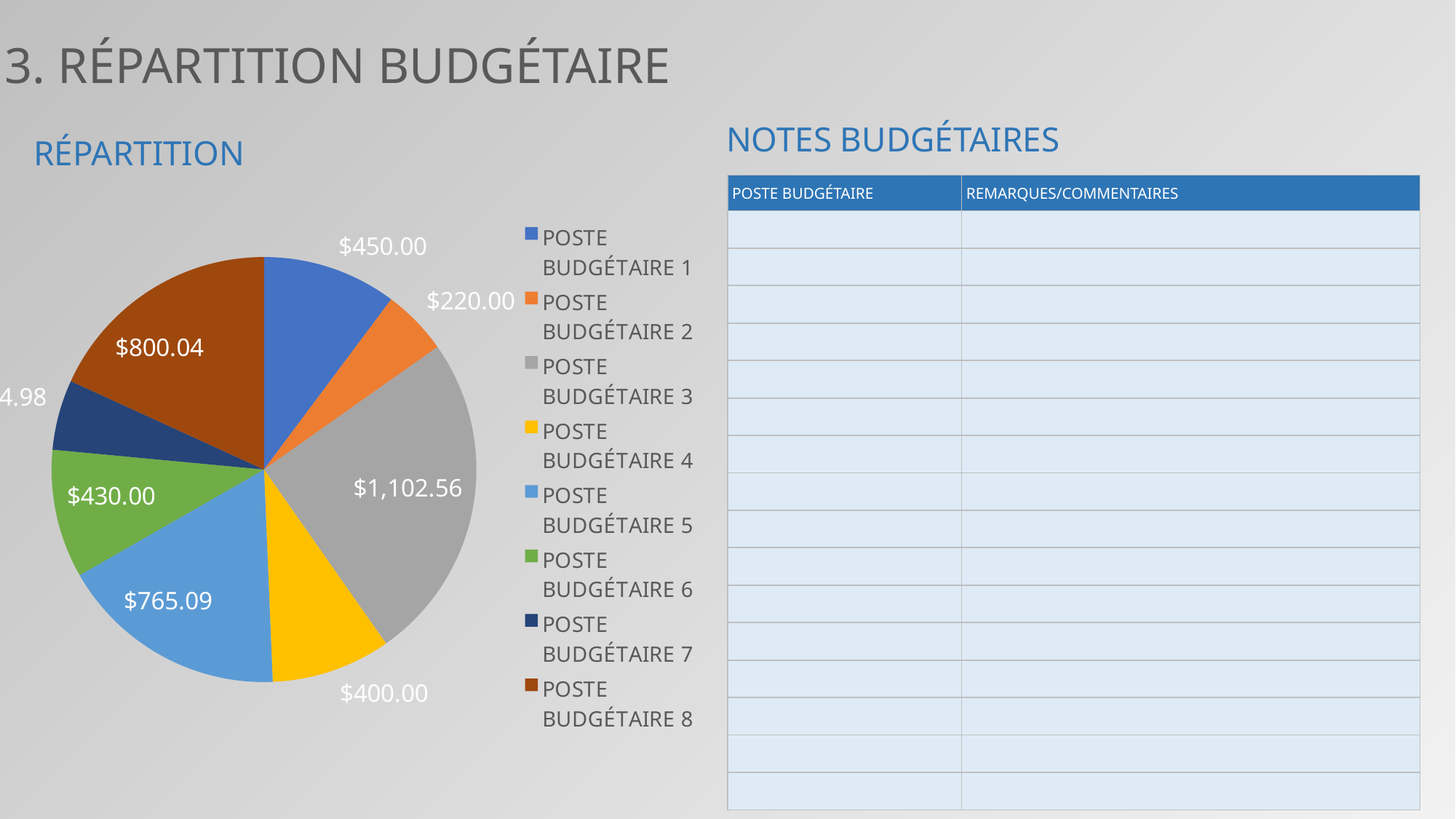
In the RÉPARTITION pie chart, which is larger: POSTE BUDGÉTAIRE 6 or POSTE BUDGÉTAIRE 4? POSTE BUDGÉTAIRE 6 In the RÉPARTITION pie chart, what is the value for POSTE BUDGÉTAIRE 8? $800.04 In the RÉPARTITION pie chart, what is the value for POSTE BUDGÉTAIRE 1? $450.00 How many slices does the RÉPARTITION pie chart have? 8 What kind of chart is shown under the heading RÉPARTITION? Pie chart How many entries does the legend of the RÉPARTITION pie chart list? 8 In the RÉPARTITION pie chart, what is the value for POSTE BUDGÉTAIRE 5? $765.09 In the RÉPARTITION pie chart, how much larger is POSTE BUDGÉTAIRE 1 than POSTE BUDGÉTAIRE 2? $230.00 In the RÉPARTITION pie chart, what is the difference between the values for POSTE BUDGÉTAIRE 8 and POSTE BUDGÉTAIRE 5? $34.95 In the RÉPARTITION pie chart, what is the value for POSTE BUDGÉTAIRE 3? $1,102.56 Which slice of the RÉPARTITION pie chart is the largest? POSTE BUDGÉTAIRE 3 What colour is the POSTE BUDGÉTAIRE 3 slice in the RÉPARTITION pie chart? Gray